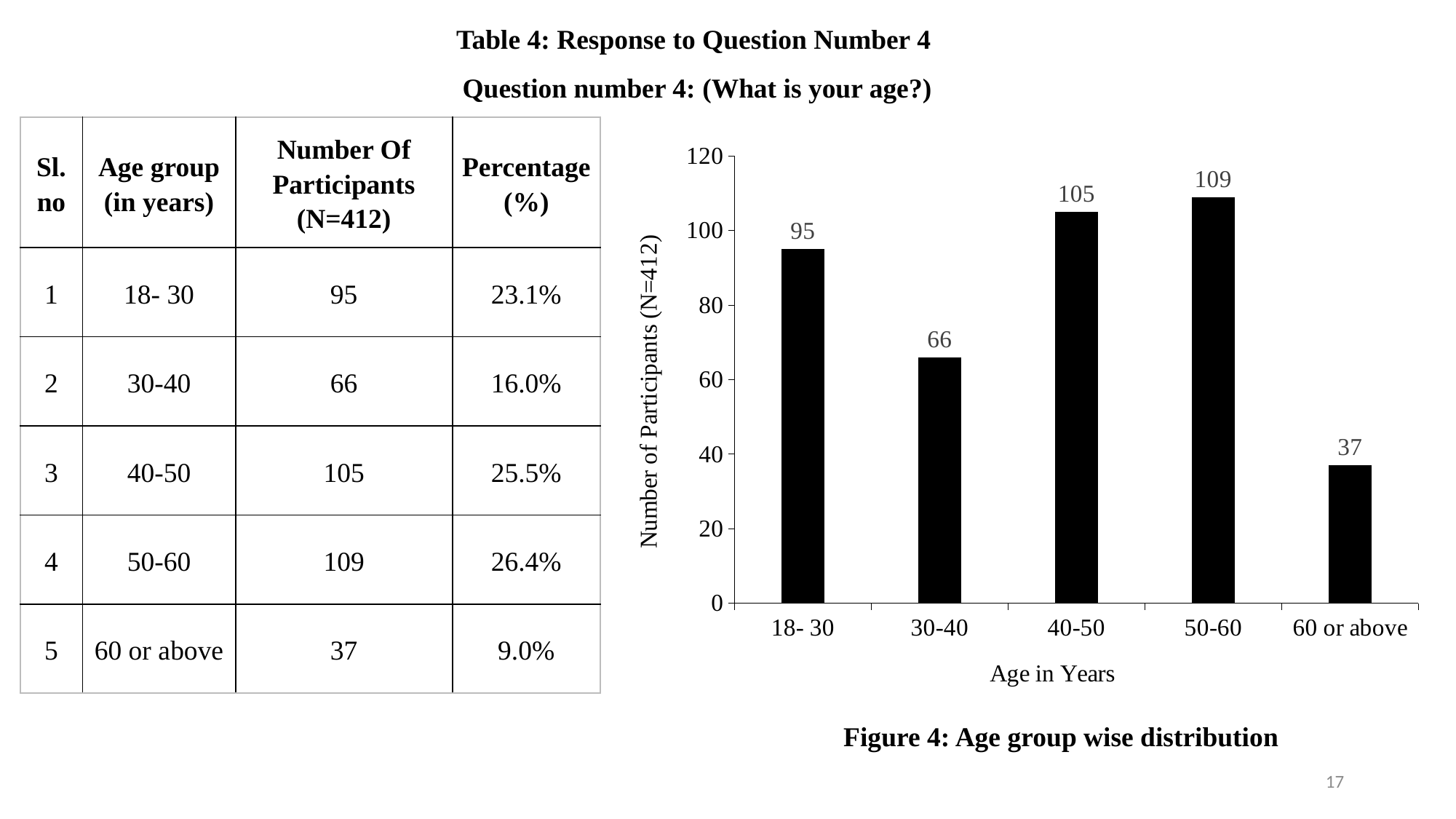
What is the number of participants in the 30-40 age group? 66 What is the number of participants in the 60 or above age group? 37 How many age groups are shown on the x axis of the chart? 5 What is the title of the x axis of the chart? Age in Years Which age group has the lowest number of participants? 60 or above Which age group has the highest number of participants? 50-60 What is the difference in number of participants between the 18- 30 and 30-40 age groups? 29 Is the value for the 40-50 age group greater or less than 100? greater What kind of chart is shown on the slide? bar chart What is the difference in number of participants between the 50-60 and 40-50 age groups? 4 Which age group has more participants, 18- 30 or 30-40? 18- 30 What is the number of participants in the 18- 30 age group? 95